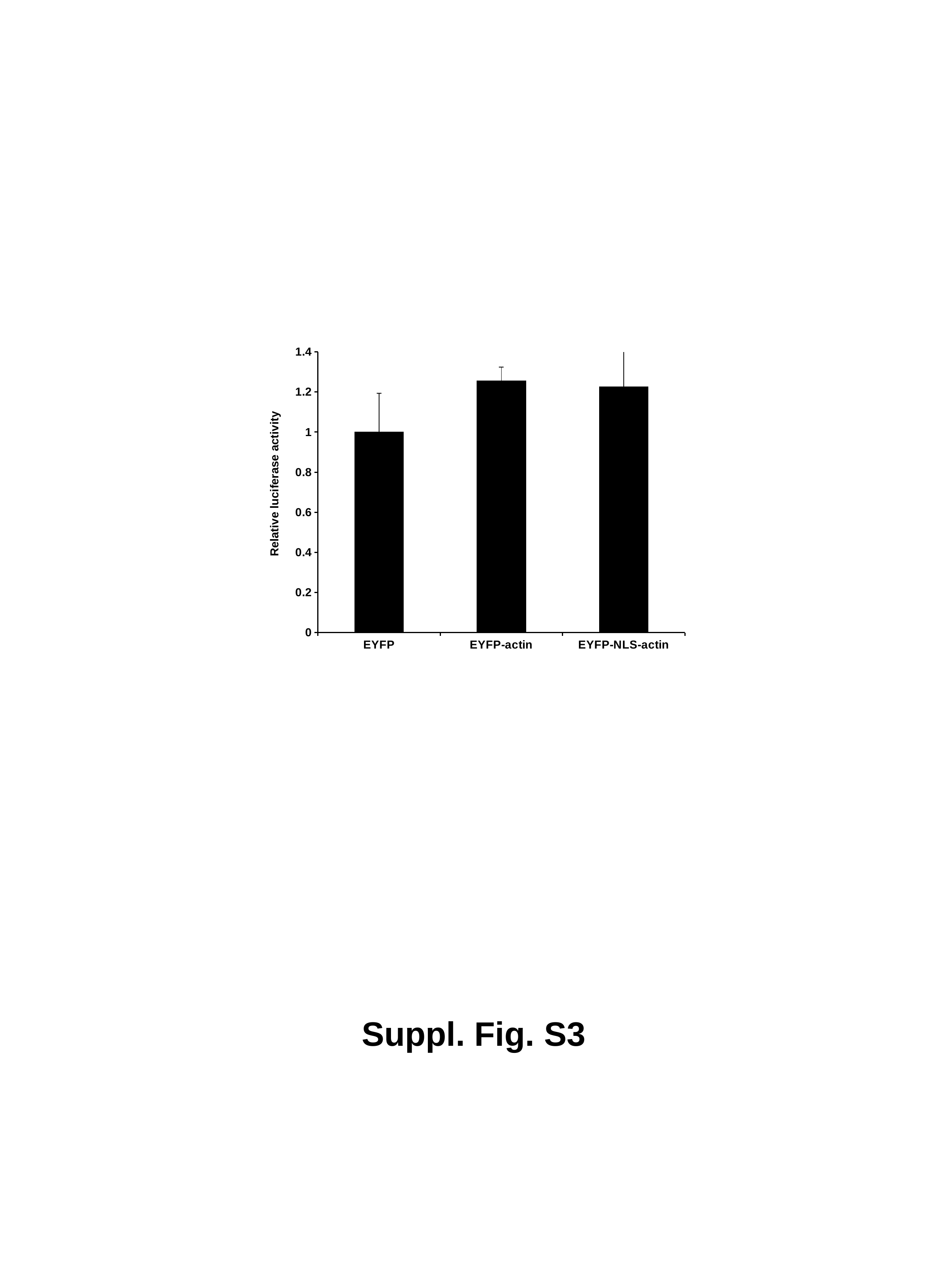
What is the relative luciferase activity for EYFP? 1 What is the label of the y axis? Relative luciferase activity Is the value for EYFP-NLS-actin greater or less than 1? greater Is the value for EYFP-actin greater or less than 1? greater Which is larger, the value for EYFP or the value for EYFP-NLS-actin? EYFP-NLS-actin Is the value for EYFP-NLS-actin greater or less than 1.4? less What kind of chart is shown on the slide? Bar chart Which is larger, the value for EYFP or the value for EYFP-actin? EYFP-actin Which category has the lowest relative luciferase activity? EYFP How many categories are plotted on the x axis? 3 What is the figure caption shown below the chart? Suppl. Fig. S3